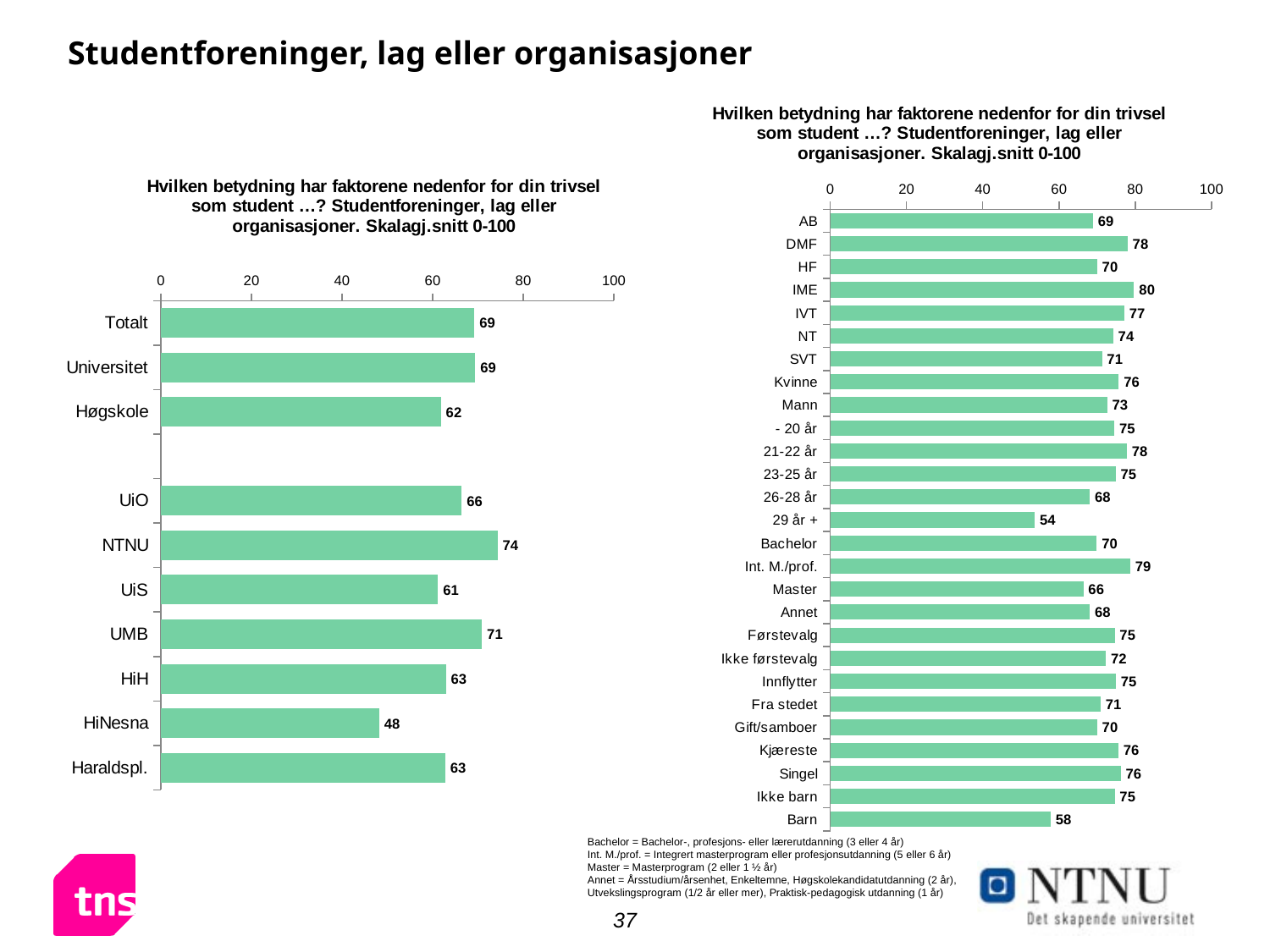
In the right chart, how many categories are plotted? 27 In the left chart, which category has the highest value? NTNU In the left chart, which category has the lowest value? HiNesna In the right chart, which is larger, the value for Kvinne or the value for Mann? Kvinne In the right chart, what is the difference between the values for Int. M./prof. and Master? 13 In the right chart, what is the value for Barn? 58 In the left chart, how many categories are plotted? 10 In the left chart, what is the difference between the values for NTNU and HiNesna? 26 In the right chart, what is the value for IME? 80 What type of chart is the left chart? Bar chart In the right chart, which category has the lowest value? 29 år + In the left chart, what is the value for NTNU? 74